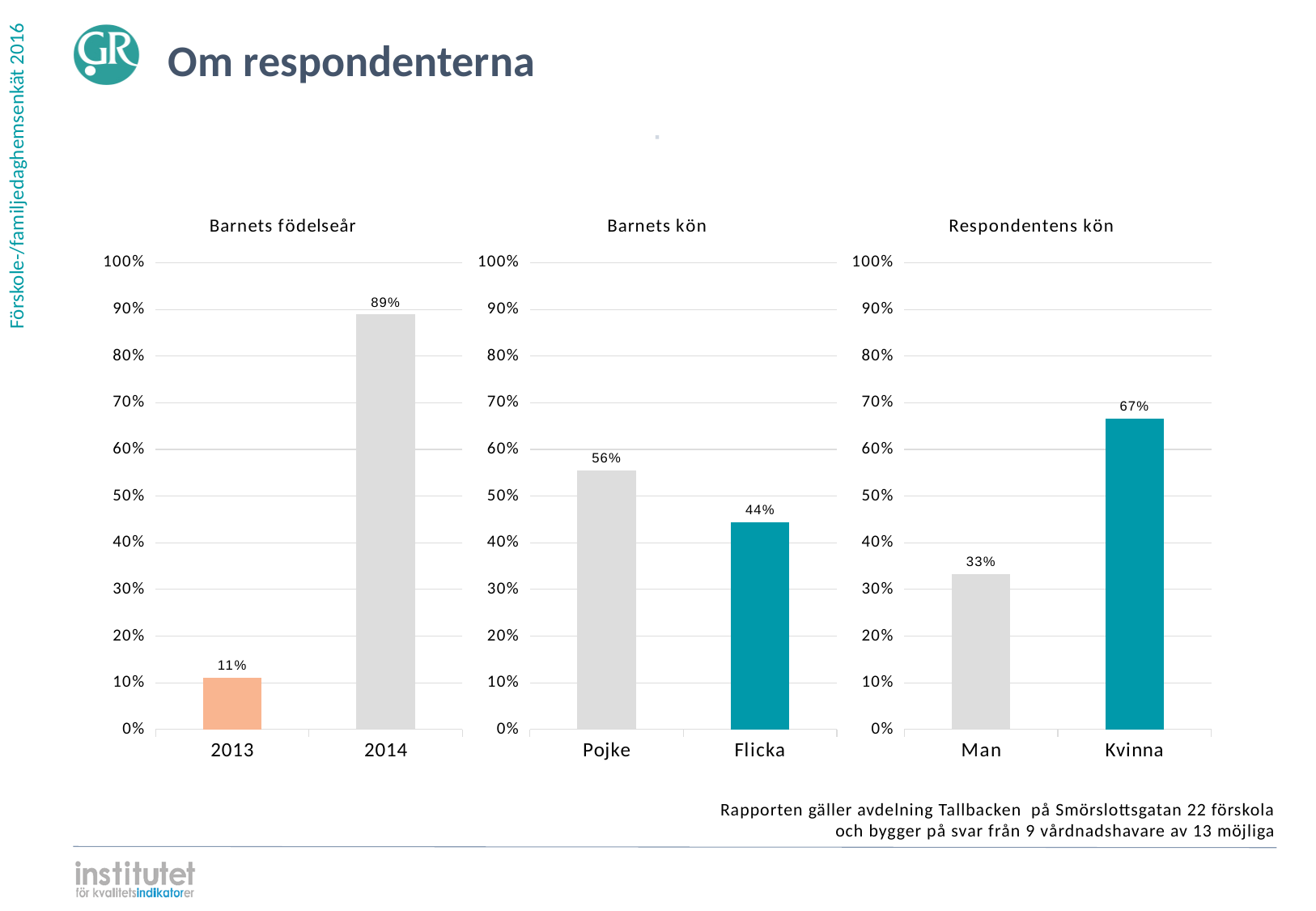
What kind of chart is the 'Respondentens kön' chart? Bar chart In the 'Barnets kön' chart, what is the value for Flicka? 44% In the 'Barnets kön' chart, what is the value for Pojke? 56% In the 'Barnets födelseår' chart, what is the difference between the values for 2014 and 2013? 78% In the 'Barnets kön' chart, which is larger, Pojke or Flicka? Pojke In the 'Respondentens kön' chart, what is the value for Kvinna? 67% How many categories are shown in the 'Barnets kön' chart? 2 In the 'Respondentens kön' chart, is the value for Man greater or less than 40%? less In the 'Barnets födelseår' chart, what is the value for 2013? 11% In the 'Respondentens kön' chart, which category has the lowest value? Man In the 'Barnets födelseår' chart, what is the value for 2014? 89% How many charts are shown on the slide? 3